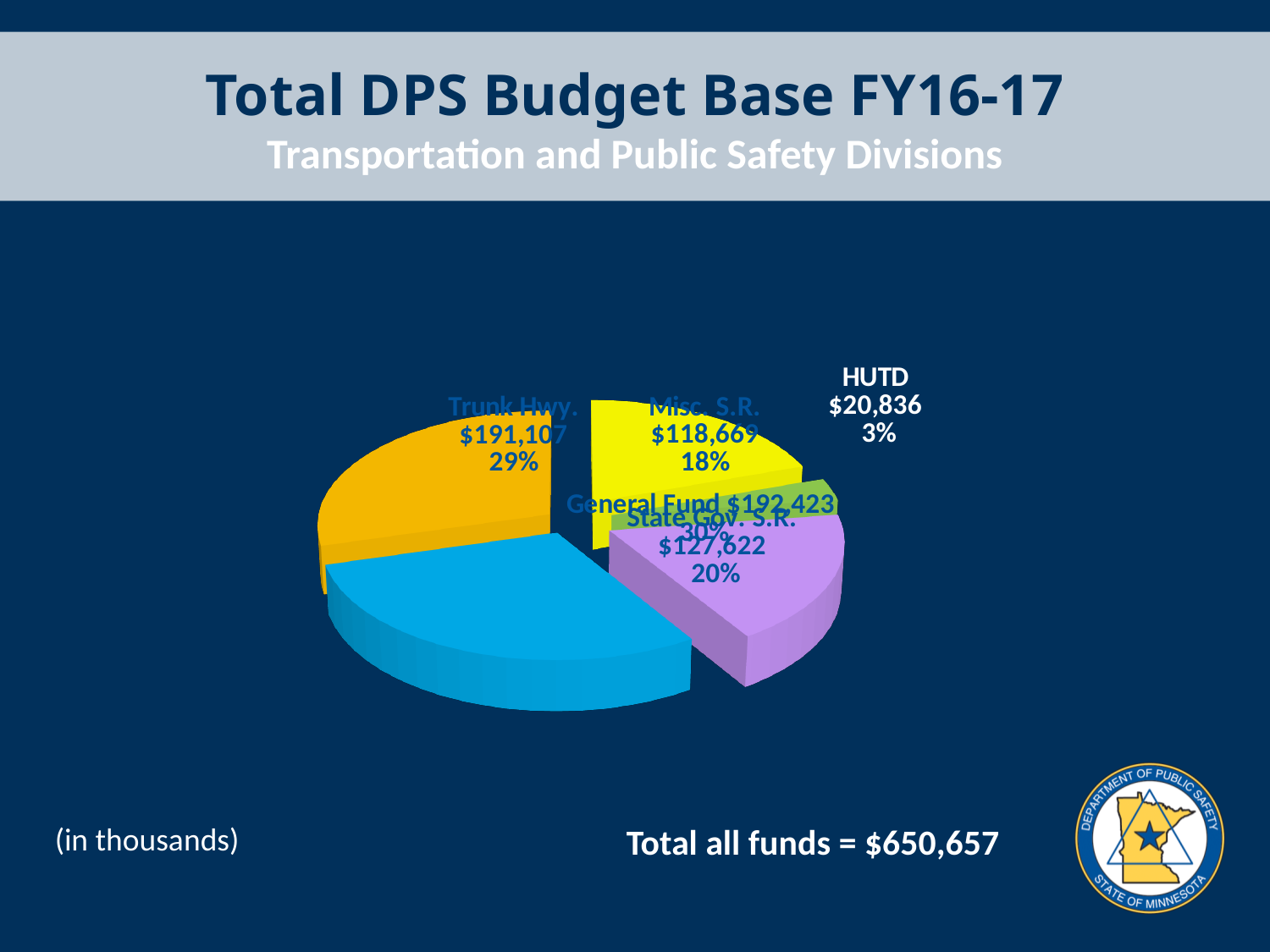
Which slice is the largest? General Fund What is the value for the HUTD slice? $20,836 What percentage share does Misc. S.R. have? 18% What percentage share does the General Fund have? 30% What is the value for the State Gov. S.R. slice? $127,622 What is the value for the General Fund slice? $192,423 What is the difference between the State Gov. S.R. value and the Misc. S.R. value? $8,953 What kind of chart is shown on the slide? pie chart What is the value for the Trunk Hwy. slice? $191,107 How many slices does the pie chart have? 5 What is the total of all funds shown on the slide? $650,657 Which slice is the smallest? HUTD